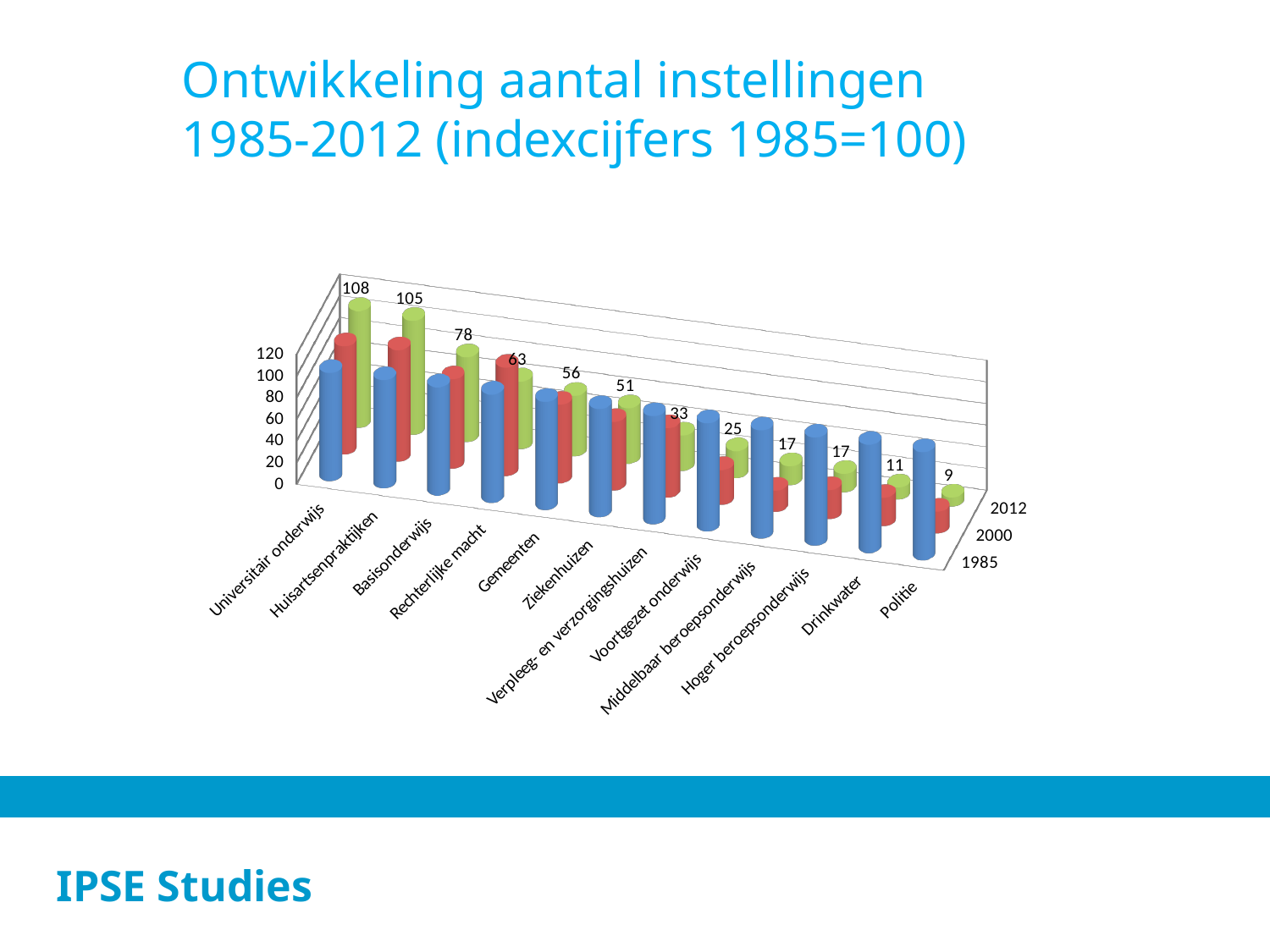
How many years (series) are plotted in the chart? 3 What type of chart is shown on the slide? Bar chart How many categories are shown on the x axis? 12 What is the 2012 index value for Verpleeg- en verzorgingshuizen? 33 What is the difference between the 2012 index values for Rechterlijke macht and Gemeenten? 7 Which category has the highest 2012 index value? Universitair onderwijs What is the difference between the 2012 index values for Universitair onderwijs and Huisartsenpraktijken? 3 Which has a higher 2012 index value, Ziekenhuizen or Voortgezet onderwijs? Ziekenhuizen What is the 2012 index value for Politie? 9 Which category has the lowest 2012 index value? Politie What is the 2012 index value for Universitair onderwijs? 108 What is the 2012 index value for Basisonderwijs? 78